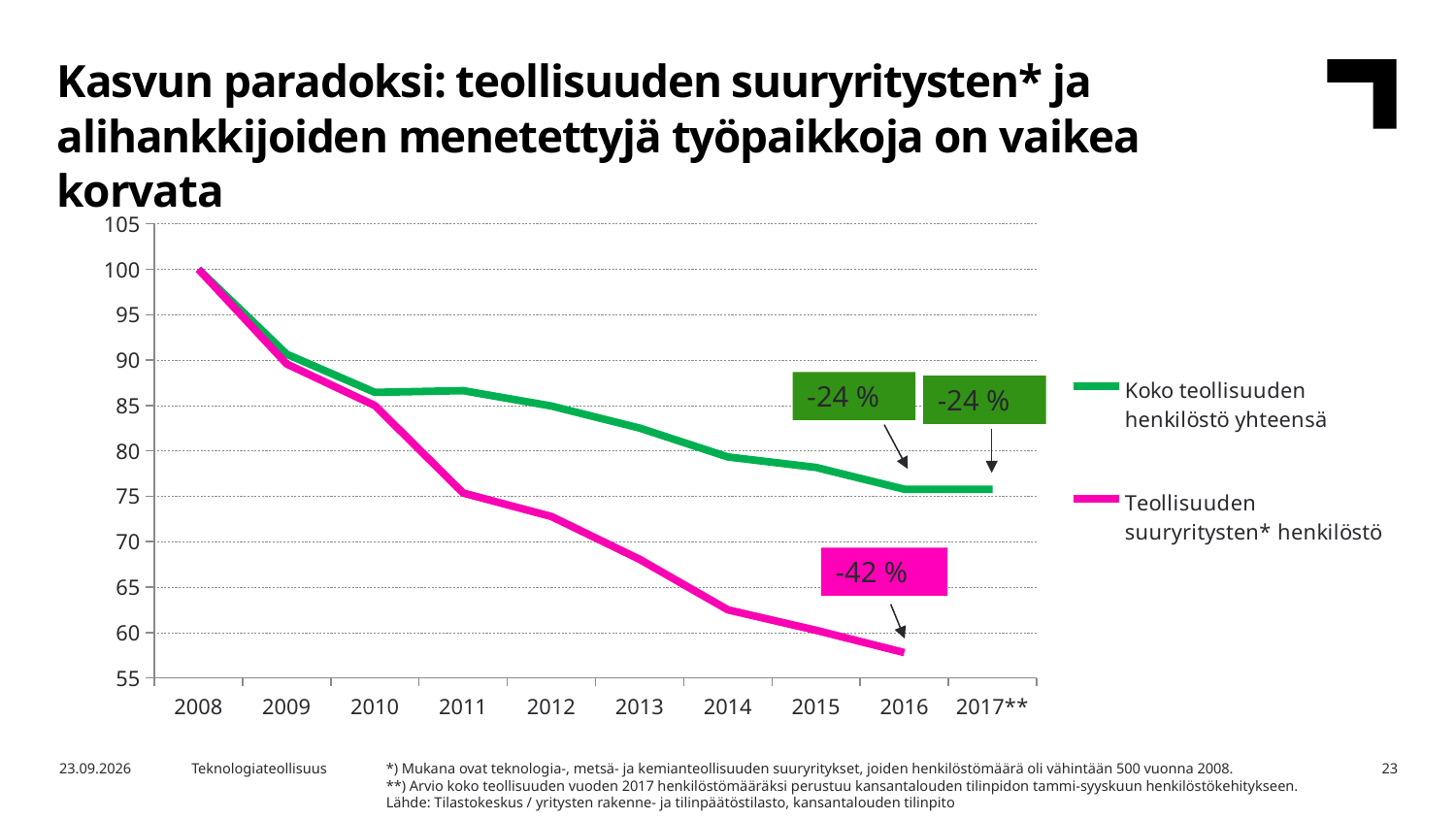
Which colour is used for the Koko teollisuuden henkilöstö yhteensä series? green What percentage change is labelled for the Teollisuuden suuryritysten* henkilöstö series at 2016? -42 % How many series does the legend list? 2 How many years are shown on the x axis? 10 In which year is the Teollisuuden suuryritysten* henkilöstö series at its lowest? 2016 Is the value for Koko teollisuuden henkilöstö yhteensä in 2010 greater or less than 85? greater What percentage change is labelled for the Koko teollisuuden henkilöstö yhteensä series at 2016? -24 % What is the value of both series in 2008? 100 Is the value for Teollisuuden suuryritysten* henkilöstö in 2016 greater or less than 60? less What kind of chart is shown on the slide? line chart Do the values of the Teollisuuden suuryritysten* henkilöstö series rise or fall from 2008 to 2016? fall In 2016, which series has the higher value: Koko teollisuuden henkilöstö yhteensä or Teollisuuden suuryritysten* henkilöstö? Koko teollisuuden henkilöstö yhteensä